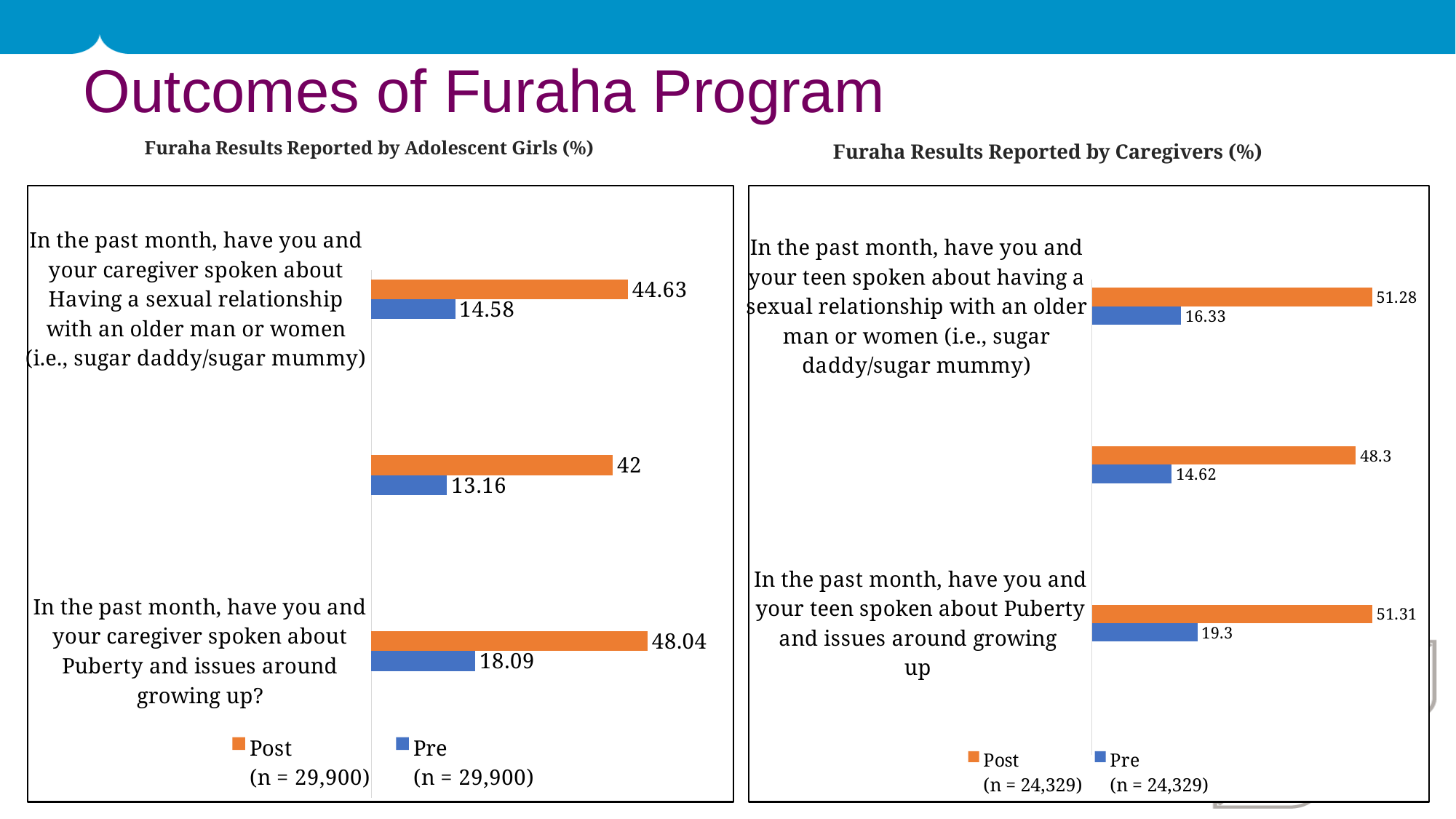
In the chart titled 'Furaha Results Reported by Caregivers (%)', is the Pre value for the puberty question larger or smaller than the Pre value for the sugar daddy/sugar mummy question? larger In the chart titled 'Furaha Results Reported by Caregivers (%)', what is the Pre value for the question about puberty and issues around growing up? 19.3 How many series does the legend list in the chart titled 'Furaha Results Reported by Caregivers (%)'? 2 In the chart titled 'Furaha Results Reported by Caregivers (%)', what sample size (n) is shown in the legend for the Post series? n = 24,329 In the chart titled 'Furaha Results Reported by Adolescent Girls (%)', what is the Pre value for the question about having a sexual relationship with an older man or woman (sugar daddy/sugar mummy)? 14.58 In the chart titled 'Furaha Results Reported by Adolescent Girls (%)', what is the Post value for the question about speaking with a caregiver about puberty and issues around growing up? 48.04 What kind of chart is the chart titled 'Furaha Results Reported by Adolescent Girls (%)'? bar chart In the chart titled 'Furaha Results Reported by Caregivers (%)', what is the Post value for the question about speaking with a teen about having a sexual relationship with an older man or woman? 51.28 In the chart titled 'Furaha Results Reported by Adolescent Girls (%)', what is the difference between the Post and Pre values for the puberty question? 29.95 In the chart titled 'Furaha Results Reported by Adolescent Girls (%)', which question has the highest Post value? In the past month, have you and your caregiver spoken about Puberty and issues around growing up? In the chart titled 'Furaha Results Reported by Caregivers (%)', what is the difference between the Post and Pre values for the sugar daddy/sugar mummy question? 34.95 In the chart titled 'Furaha Results Reported by Adolescent Girls (%)', which question has the lowest Pre value among the labelled questions? In the past month, have you and your caregiver spoken about Having a sexual relationship with an older man or women (i.e., sugar daddy/sugar mummy)